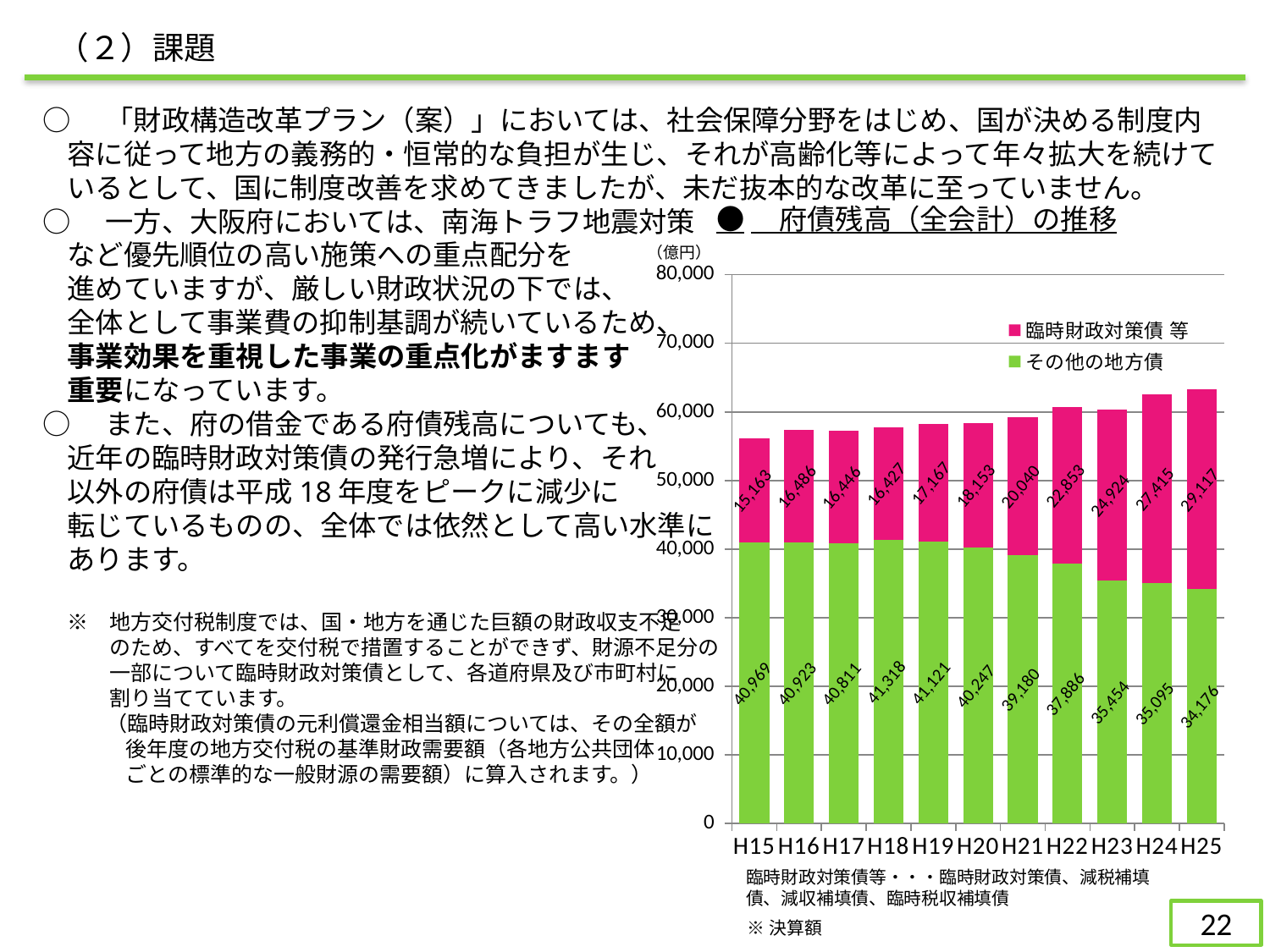
How many series does the legend of the chart list? 2 What is the difference between the 臨時財政対策債 等 values for H25 and H15? 13,954 Which is larger, その他の地方債 in H15 or in H25? H15 What is the title of the chart? 府債残高（全会計）の推移 How many fiscal years (categories) are plotted on the x axis of the chart? 11 What is the total of the stacked bar for H25? 63,293 What is the value of 臨時財政対策債 等 for H25? 29,117 What kind of chart is shown on the slide? Stacked bar chart In which year is 臨時財政対策債 等 at its lowest? H15 Does 臨時財政対策債 等 rise or fall from H19 to H25? Rise What is the value of その他の地方債 for H18? 41,318 In which year is その他の地方債 at its highest? H18